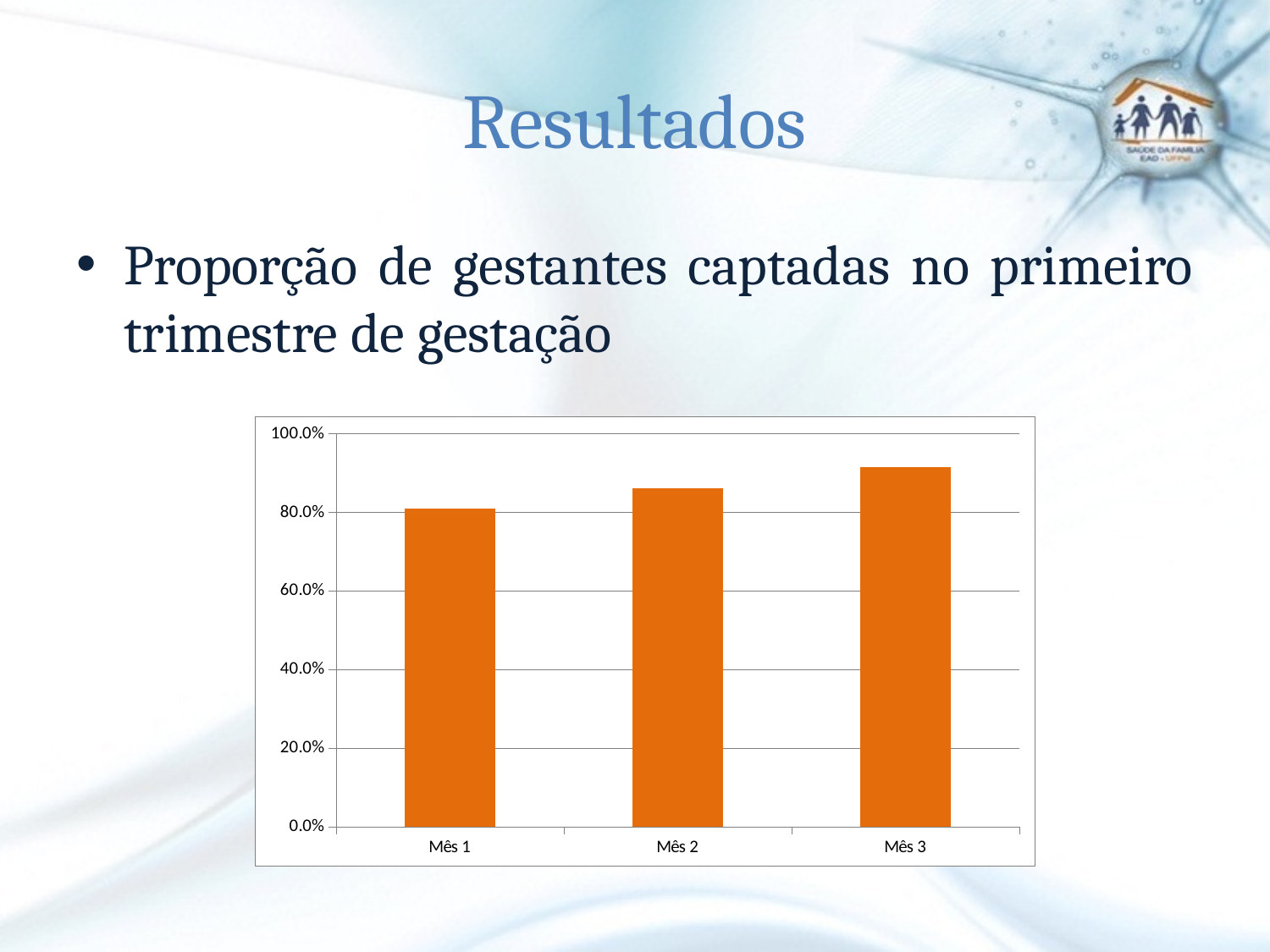
Is the value for Mês 2 greater or less than 80.0%? greater Which month has the highest proportion in the chart? Mês 3 Which is larger, the value for Mês 3 or the value for Mês 2? Mês 3 Is the value for Mês 1 greater or less than 60.0%? greater Do the values rise or fall from Mês 1 to Mês 3? rise Which month has the lowest proportion in the chart? Mês 1 What kind of chart is shown on the slide? bar chart Is the value for Mês 3 greater or less than 100.0%? less What colour are the bars in the chart? orange Which is larger, the value for Mês 2 or the value for Mês 1? Mês 2 How many categories are plotted on the x axis of the chart? 3